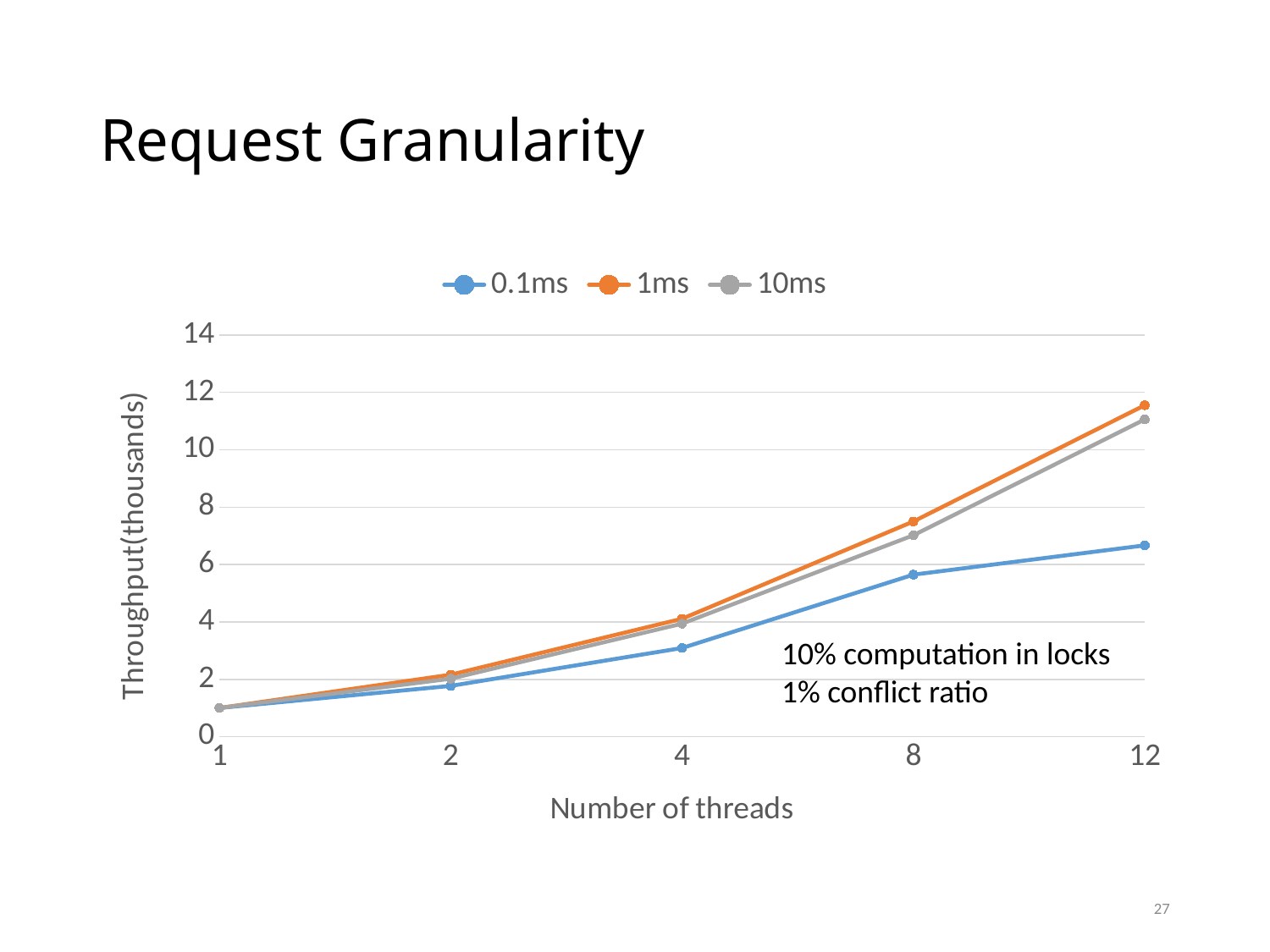
Is the throughput for the 1ms series at 12 threads greater or less than 10? greater How many thread-count points are plotted along the x axis? 5 Which series has the lowest throughput at 12 threads? 0.1ms Is the throughput for the 0.1ms series at 12 threads greater or less than 8? less What is the title of the y axis? Throughput(thousands) Is the throughput for the 10ms series at 8 threads greater or less than 6? greater At 12 threads, which series has the higher throughput, 1ms or 0.1ms? 1ms How many series does the legend list? 3 What kind of chart is shown on the slide? line chart Does the throughput for the 1ms series rise or fall as the number of threads increases? rises What is the title of the x axis? Number of threads